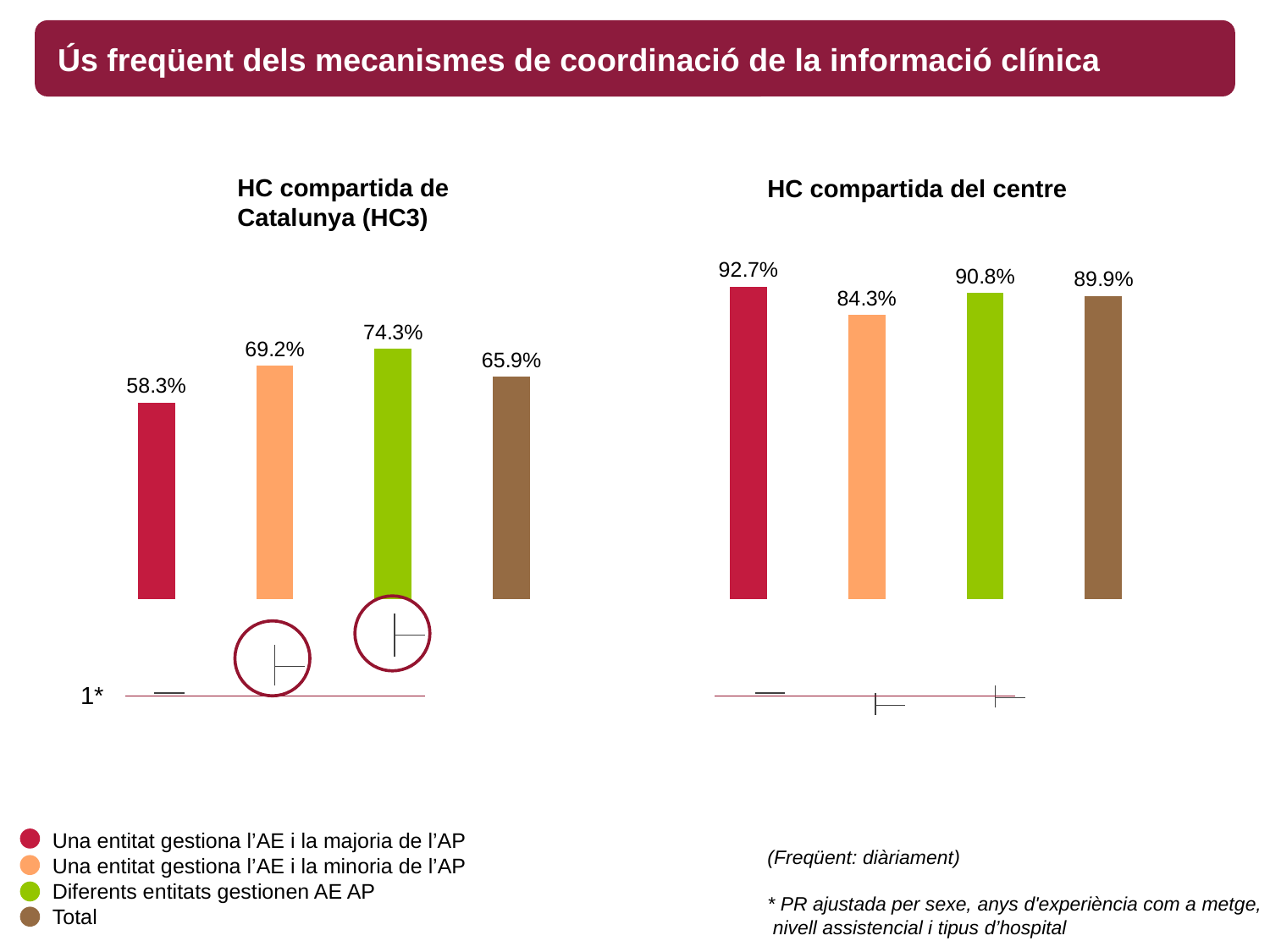
Is the value for 'Total' larger in the 'HC compartida del centre' chart or in the 'HC compartida de Catalunya (HC3)' chart? HC compartida del centre In the 'HC compartida de Catalunya (HC3)' chart, what is the difference between the values for 'Diferents entitats gestionen AE AP' and 'Una entitat gestiona l'AE i la majoria de l'AP'? 16 percentage points In the 'HC compartida del centre' chart, what is the difference between the values for 'Una entitat gestiona l'AE i la majoria de l'AP' and 'Una entitat gestiona l'AE i la minoria de l'AP'? 8.4 percentage points In the 'HC compartida del centre' chart, which category has the lowest value? Una entitat gestiona l'AE i la minoria de l'AP In the 'HC compartida de Catalunya (HC3)' chart, what is the value for 'Diferents entitats gestionen AE AP'? 74.3% What type of chart is used for 'HC compartida de Catalunya (HC3)'? Bar chart In the 'HC compartida del centre' chart, what is the value for 'Una entitat gestiona l'AE i la minoria de l'AP'? 84.3% In the 'HC compartida de Catalunya (HC3)' chart, what is the value for 'Total'? 65.9% In the 'HC compartida del centre' chart, what is the value for 'Una entitat gestiona l'AE i la majoria de l'AP'? 92.7% In the 'HC compartida de Catalunya (HC3)' chart, which category has the lowest value? Una entitat gestiona l'AE i la majoria de l'AP How many bars does the 'HC compartida del centre' chart show? 4 In the 'HC compartida de Catalunya (HC3)' chart, which category has the highest value? Diferents entitats gestionen AE AP